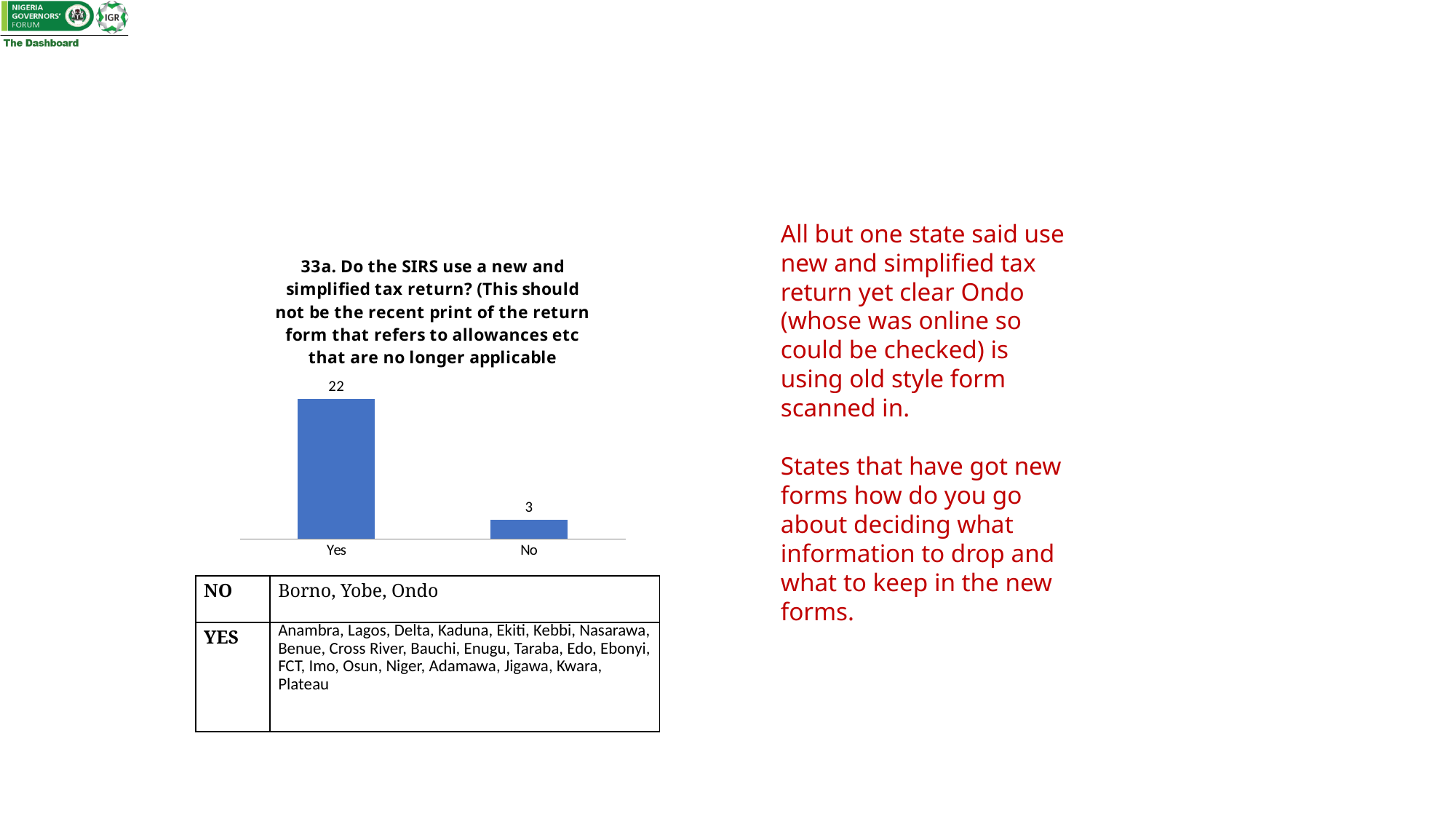
What colour are the bars in the chart? Blue What is the difference between the Yes and No values? 19 What question number does the chart title begin with? 33a Which category has the highest value? Yes How many categories are shown on the x axis? 2 What is the value for No? 3 Which category has the lowest value? No Do the values rise or fall from Yes to No along the x axis? Fall What kind of chart is shown? Bar chart What is the total of the Yes and No values? 25 Which is larger, the value for Yes or the value for No? Yes What is the value for Yes? 22